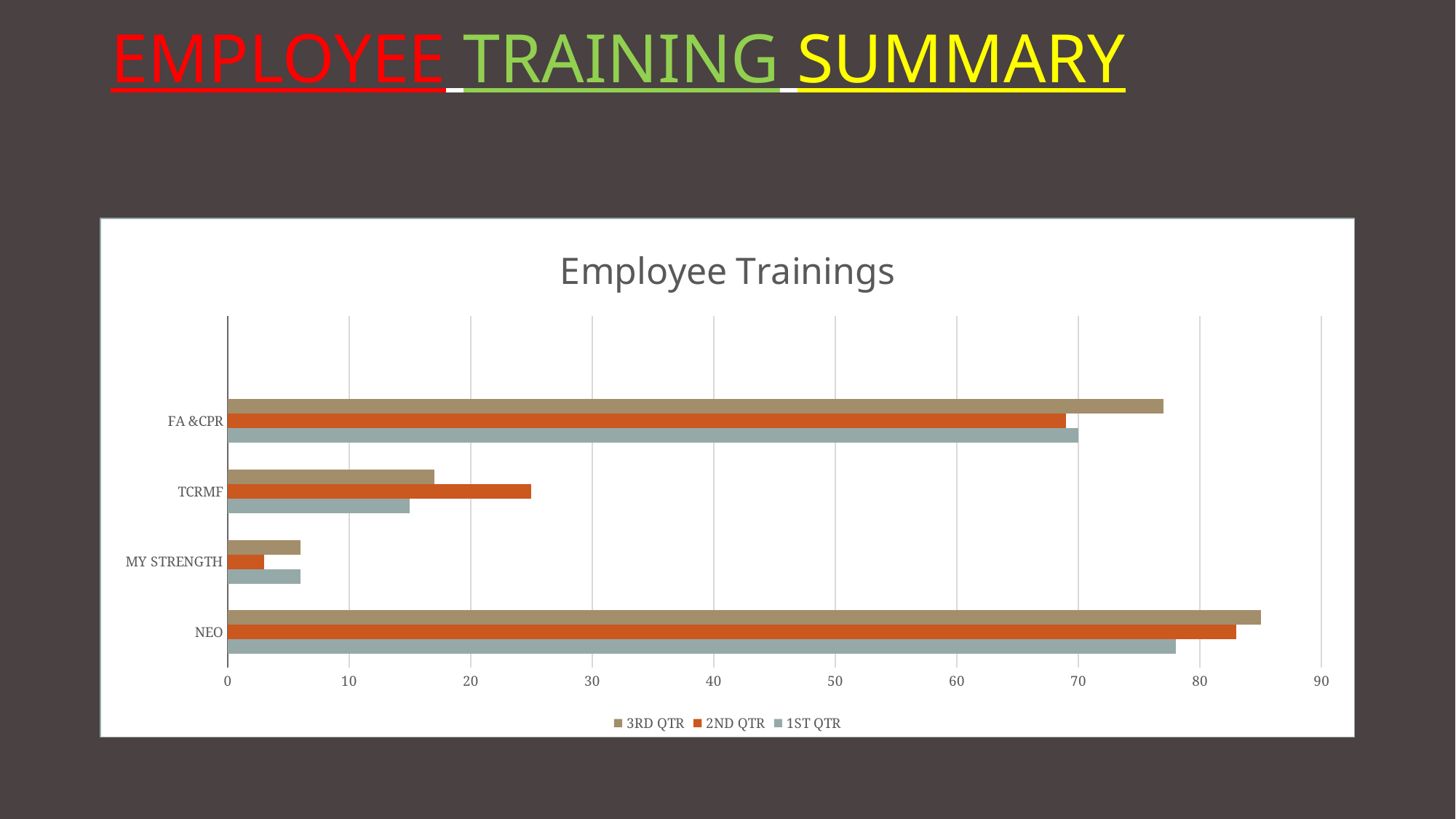
For NEO, which is larger: the 3RD QTR value or the 1ST QTR value? 3RD QTR What type of chart is shown on the slide? bar chart Is the 2ND QTR value for TCRMF greater or less than 20? greater Is the 3RD QTR value for FA &CPR greater or less than 70? greater Which training category has the lowest 2ND QTR value? MY STRENGTH For TCRMF, which is larger: the 2ND QTR value or the 1ST QTR value? 2ND QTR Which training category has the highest 3RD QTR value? NEO How many training categories are shown on the chart? 4 Is the 3RD QTR value for NEO greater or less than 80? greater What is the title of the chart? Employee Trainings How many series does the legend list? 3